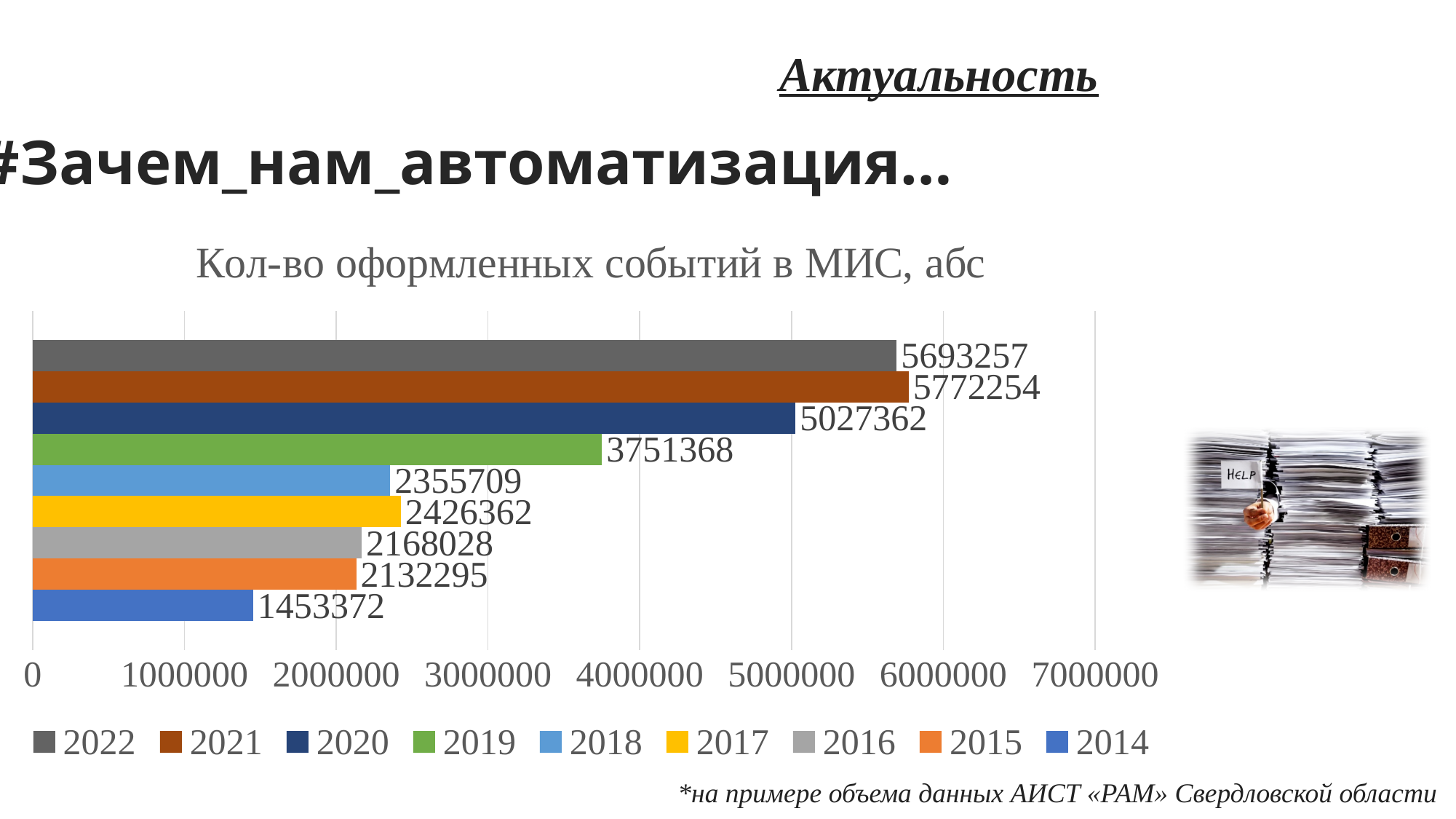
Which year has the highest number of events? 2021 What is the difference between the values for 2021 and 2022? 78997 What kind of chart is shown on the slide? bar chart What is the value for 2022 in the chart "Кол-во оформленных событий в МИС, абс"? 5693257 How many entries does the legend list? 9 What is the value for 2014? 1453372 How many bars are shown in the chart? 9 Is the value for 2019 greater or less than 3000000? greater Which is larger, the value for 2017 or the value for 2018? 2017 What is the difference between the values for 2020 and 2019? 1275994 Which year has the lowest number of events? 2014 What is the value for 2019? 3751368